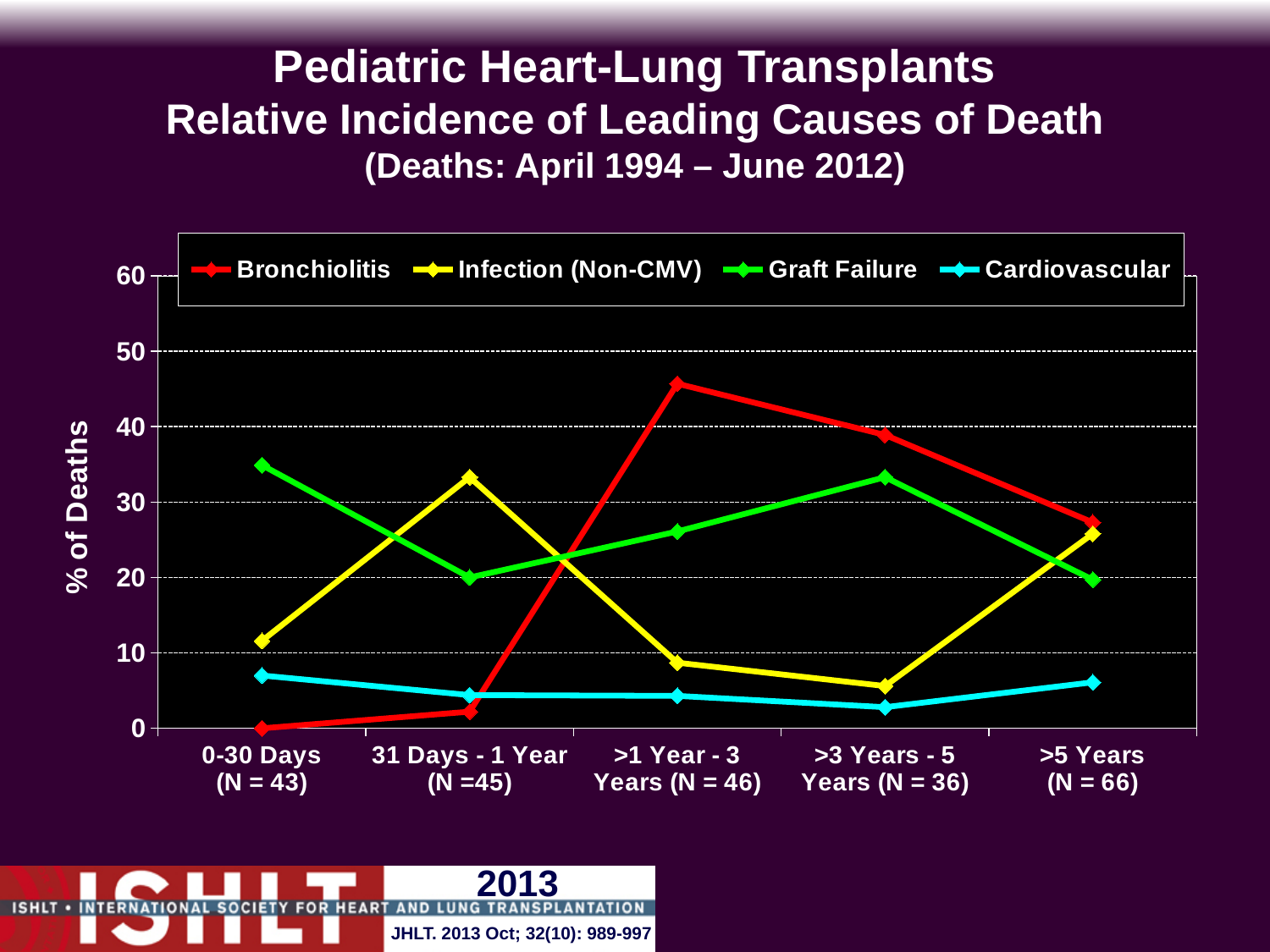
In the 0-30 Days (N = 43) period, which is larger: Graft Failure or Infection (Non-CMV)? Graft Failure How many series does the legend list? 4 In which period does Bronchiolitis reach its highest % of Deaths? >1 Year - 3 Years (N = 46) In which period is Infection (Non-CMV) at its lowest % of Deaths? >3 Years - 5 Years (N = 36) Which series is shown in red in the legend? Bronchiolitis What is the label of the y axis? % of Deaths What kind of chart is shown on the slide? line chart How many time-period categories are shown on the x axis? 5 Is the value for Graft Failure in the 0-30 Days period greater or less than 30? greater Which cause of death has the highest % of Deaths in the >1 Year - 3 Years (N = 46) period? Bronchiolitis Is the value for Cardiovascular in the >5 Years period greater or less than 10? less Is the value for Bronchiolitis in the >1 Year - 3 Years period greater or less than 40? greater